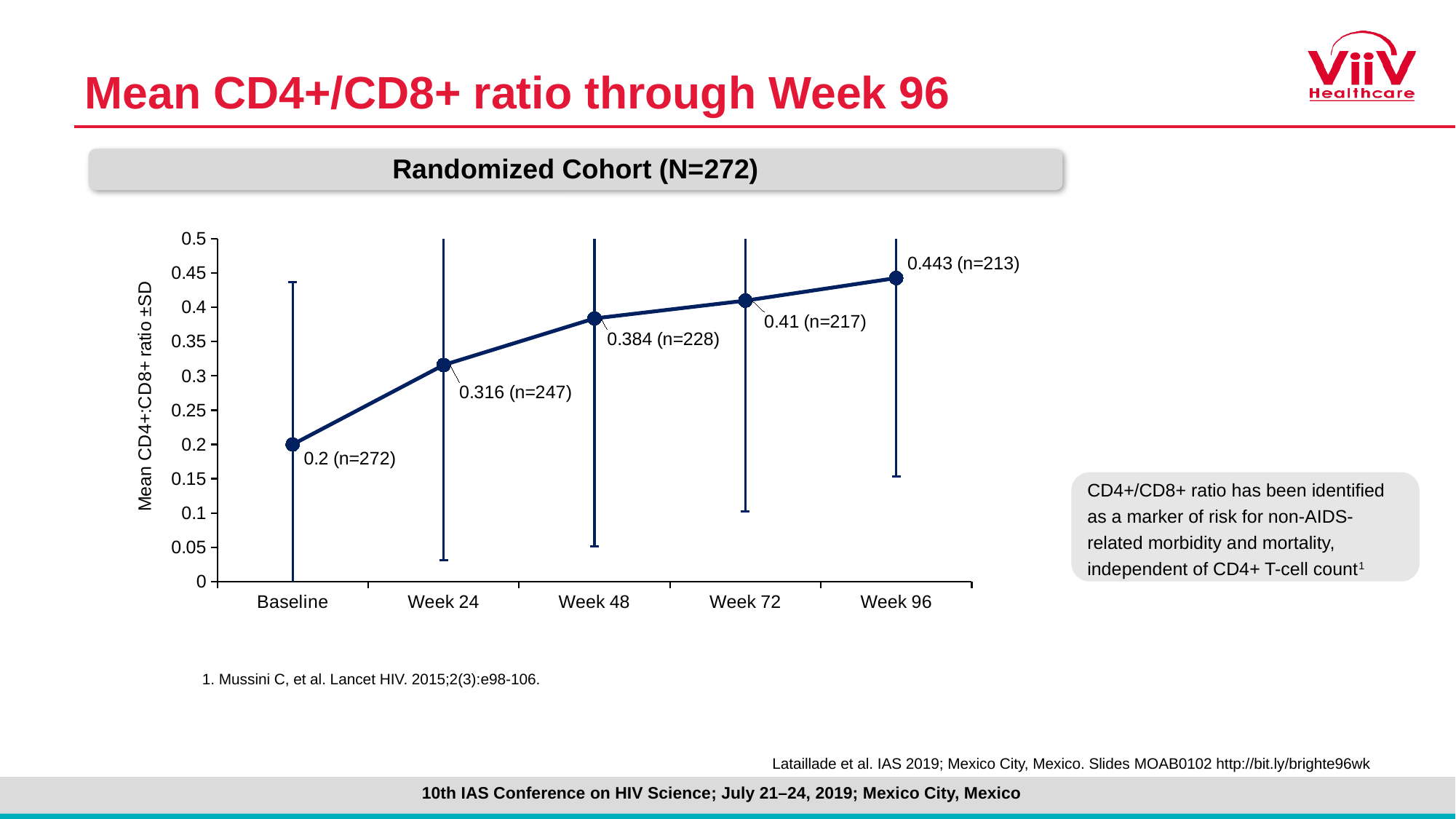
What is the mean CD4+/CD8+ ratio at Week 48? 0.384 What is the label of the y-axis? Mean CD4+:CD8+ ratio ±SD What kind of chart is shown on the slide? Line chart How many time points are plotted on the chart? 5 At which time point is the mean CD4+/CD8+ ratio highest? Week 96 What is the mean CD4+/CD8+ ratio at Baseline? 0.2 What is the difference between the mean CD4+/CD8+ ratio at Week 96 and at Baseline? 0.243 Does the mean CD4+/CD8+ ratio rise or fall from Baseline to Week 96? Rise How many participants (n) contributed to the Week 24 value? 247 At which time point is the mean CD4+/CD8+ ratio lowest? Baseline What is the mean CD4+/CD8+ ratio at Week 96? 0.443 Which is larger, the mean ratio at Week 24 or at Week 72? Week 72